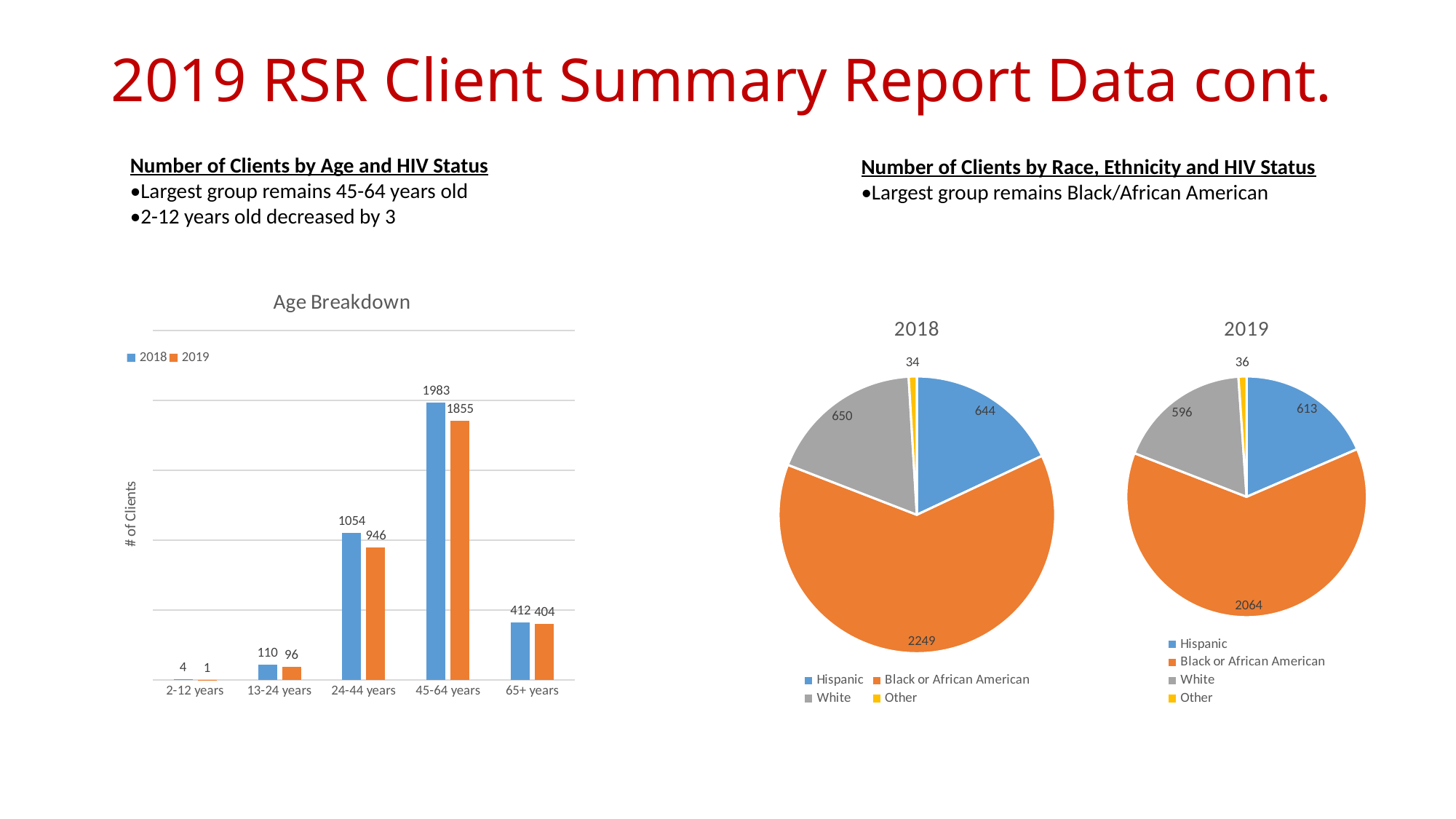
In the Age Breakdown chart, which age group has the highest 2018 value? 45-64 years In the 2019 pie chart, what is the value for Black or African American? 2064 In the Age Breakdown chart, what is the 2018 value for 24-44 years? 1054 In the Age Breakdown chart, what is the 2019 value for 45-64 years? 1855 In the Age Breakdown chart, how many age groups are shown on the x axis? 5 In the Age Breakdown chart, how many series does the legend list? 2 In the 2019 pie chart, which category has the smallest slice? Other What kind of chart is the Age Breakdown chart? Bar chart In the 2018 pie chart, what is the value for White? 650 In the Age Breakdown chart, which age group has the lowest 2019 value? 2-12 years In the Age Breakdown chart, what is the difference between the 2018 and 2019 values for 13-24 years? 14 In the 2018 pie chart, is the value for Hispanic larger or smaller than the value for White? Smaller